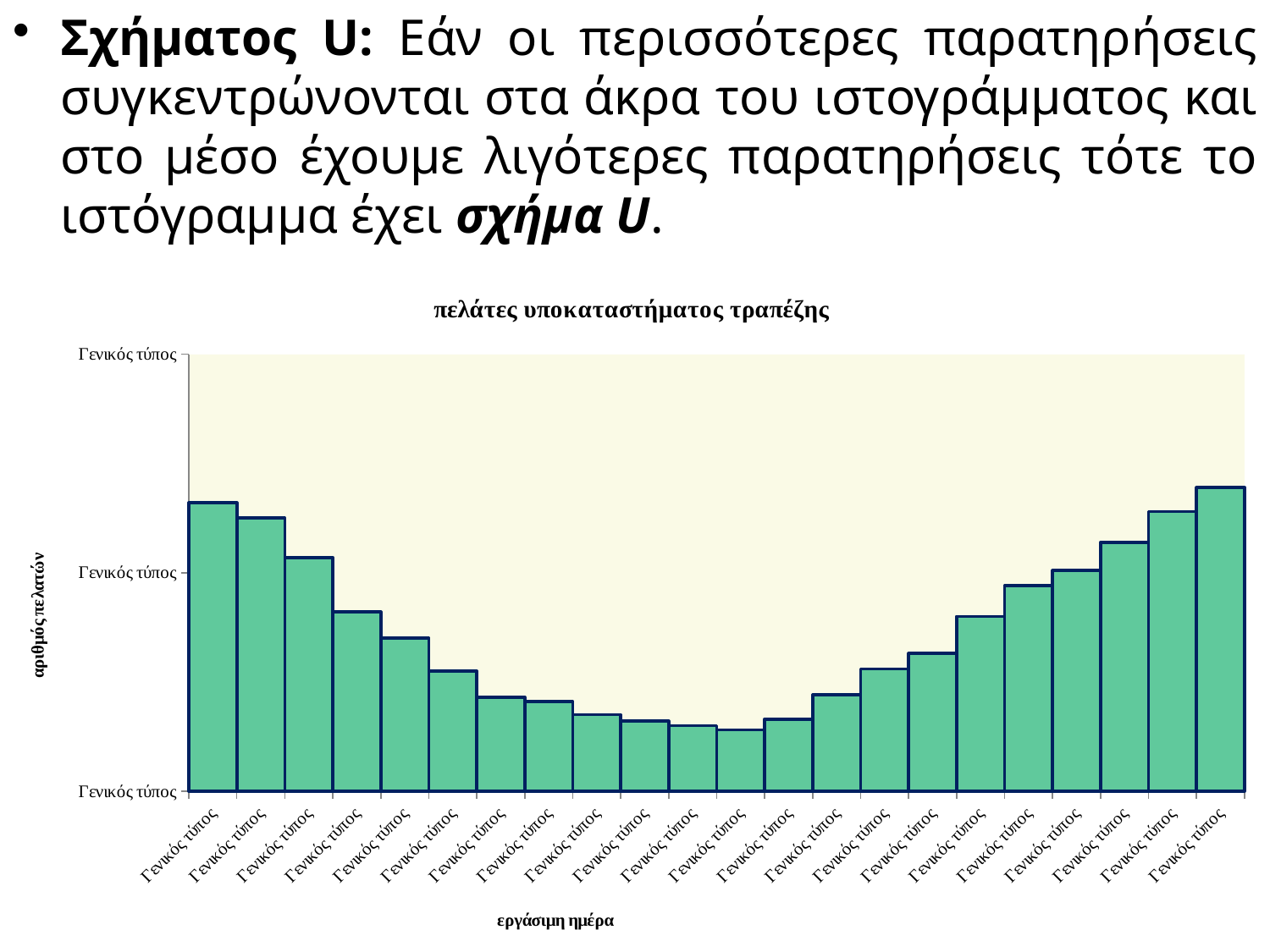
How many bars does the chart contain? 22 What is the title of the chart? πελάτες υποκαταστήματος τραπέζης Which bar is taller, the leftmost bar or the rightmost bar? the rightmost bar What kind of chart is shown on the slide? bar chart What is the title of the vertical axis of the chart? αριθμός πελατών Which bar is taller, the second bar from the left or the second bar from the right? the second bar from the right Where is the tallest bar located in the chart: at the left end, in the middle, or at the right end? at the right end Do the bar heights rise or fall from the middle of the chart toward the rightmost bar? rise Where is the shortest bar located in the chart: at the left end, in the middle, or at the right end? in the middle Overall, what shape does the histogram on the slide have? U shape Do the bar heights rise or fall from the leftmost bar toward the middle of the chart? fall